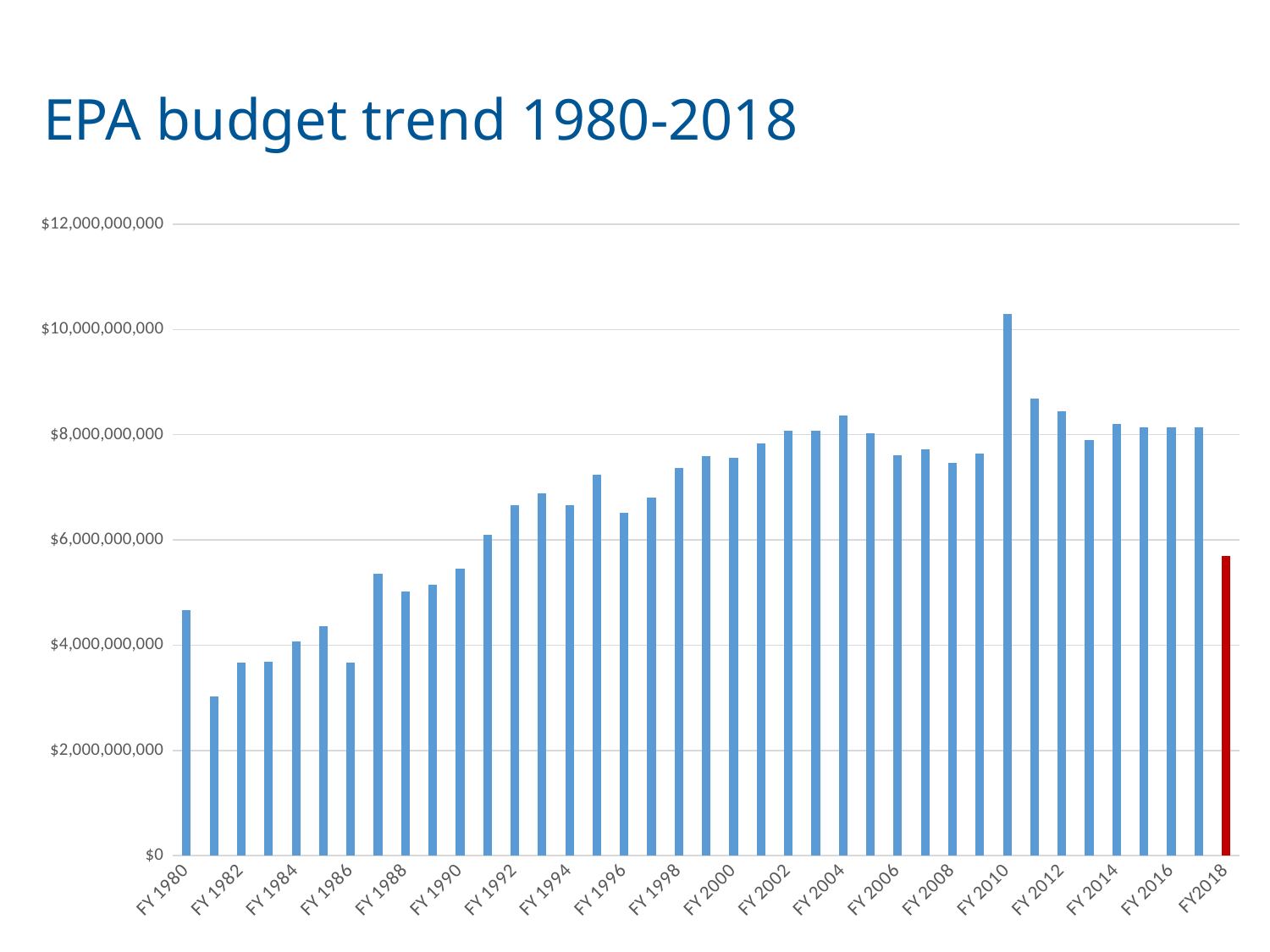
Which fiscal year has the highest EPA budget in the chart? FY 2010 Is the value for FY 1980 greater or less than $4,000,000,000? greater What colour is the bar for FY2018? red Is the value for FY 2010 greater or less than $10,000,000,000? greater Is the value for FY 2004 greater or less than $8,000,000,000? greater What kind of chart is shown on the slide? bar chart Which is larger, the value for FY 2010 or the value for FY2018? FY 2010 Which fiscal year has the lowest EPA budget in the chart? FY 1981 What is the title of the chart? EPA budget trend 1980-2018 Which is larger, the value for FY 1980 or the value for FY 1982? FY 1980